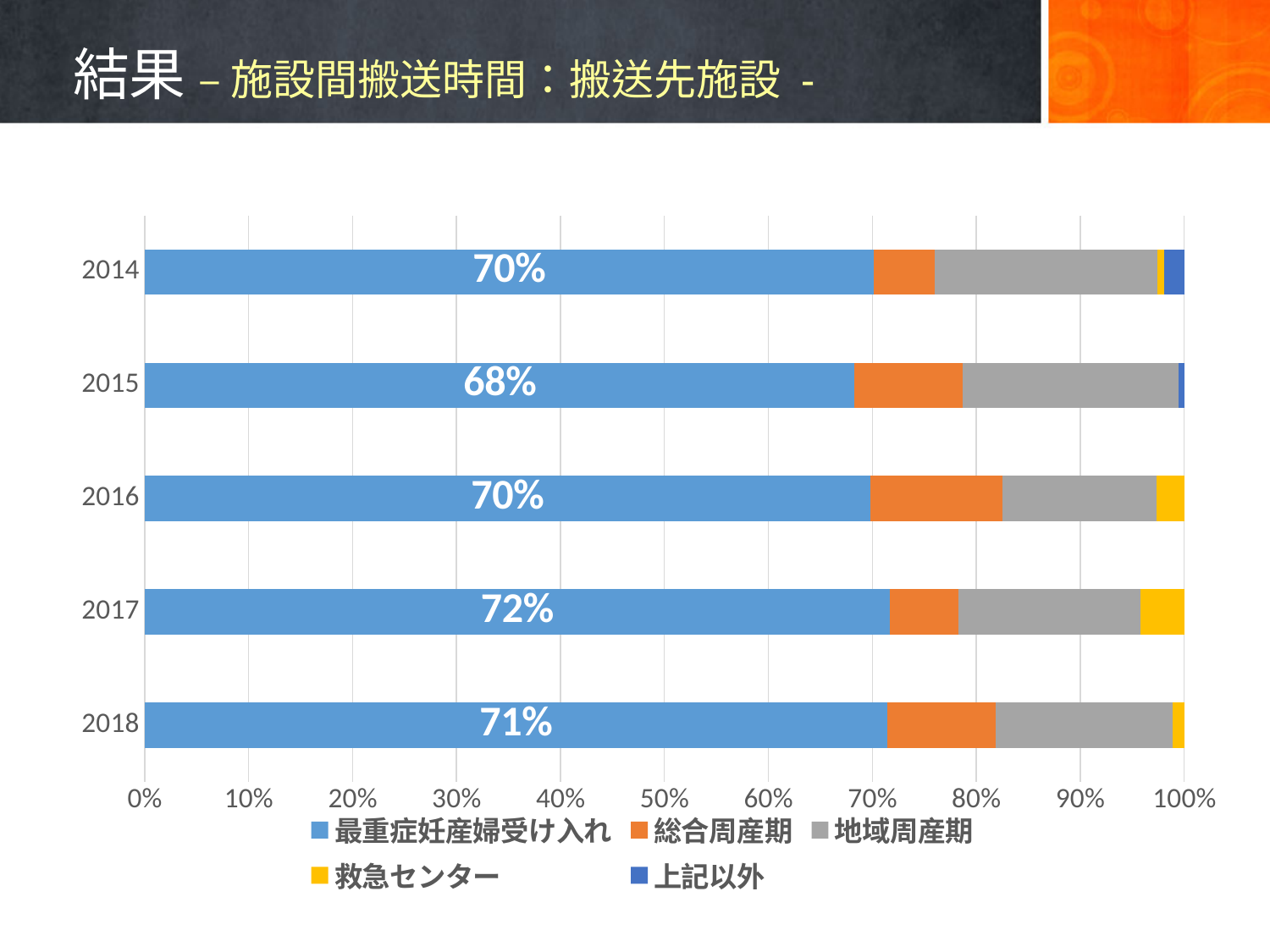
What is the value for 最重症妊産婦受け入れ in 2015? 68% What is the value for 最重症妊産婦受け入れ in 2018? 71% Which year has a larger 最重症妊産婦受け入れ value, 2018 or 2015? 2018 What kind of chart is shown on the slide? Stacked bar chart In which year is the share of 最重症妊産婦受け入れ the highest? 2017 What is the value for 最重症妊産婦受け入れ in 2014? 70% How many series does the legend list? 5 What is the value for 最重症妊産婦受け入れ in 2017? 72% In which year is the share of 最重症妊産婦受け入れ the lowest? 2015 How many years are shown on the chart? 5 What is the difference between the 最重症妊産婦受け入れ values for 2017 and 2015? 4% Is the value for 最重症妊産婦受け入れ in 2016 greater or less than 60%? greater